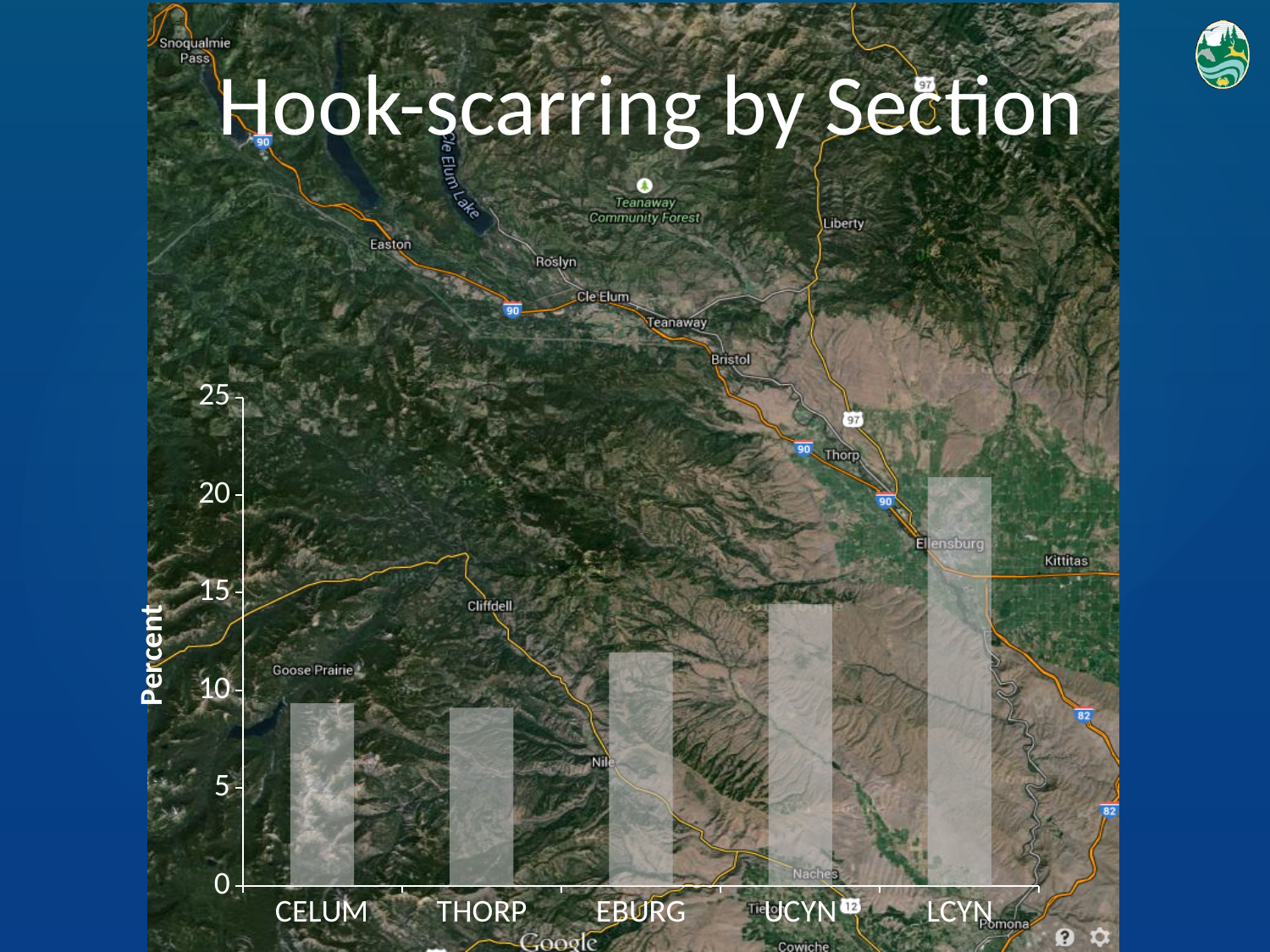
Is the value for CELUM greater or less than 10? less Is the value for EBURG greater or less than 10? greater What kind of chart is shown on the slide? bar chart Is the value for UCYN greater or less than 15? less What is the label on the y axis? Percent What is the title of the chart? Hook-scarring by Section Which is larger, the value for EBURG or the value for THORP? EBURG Which is larger, the value for LCYN or the value for UCYN? LCYN Which section has the highest hook-scarring percent? LCYN How many sections (categories) are plotted on the x axis? 5